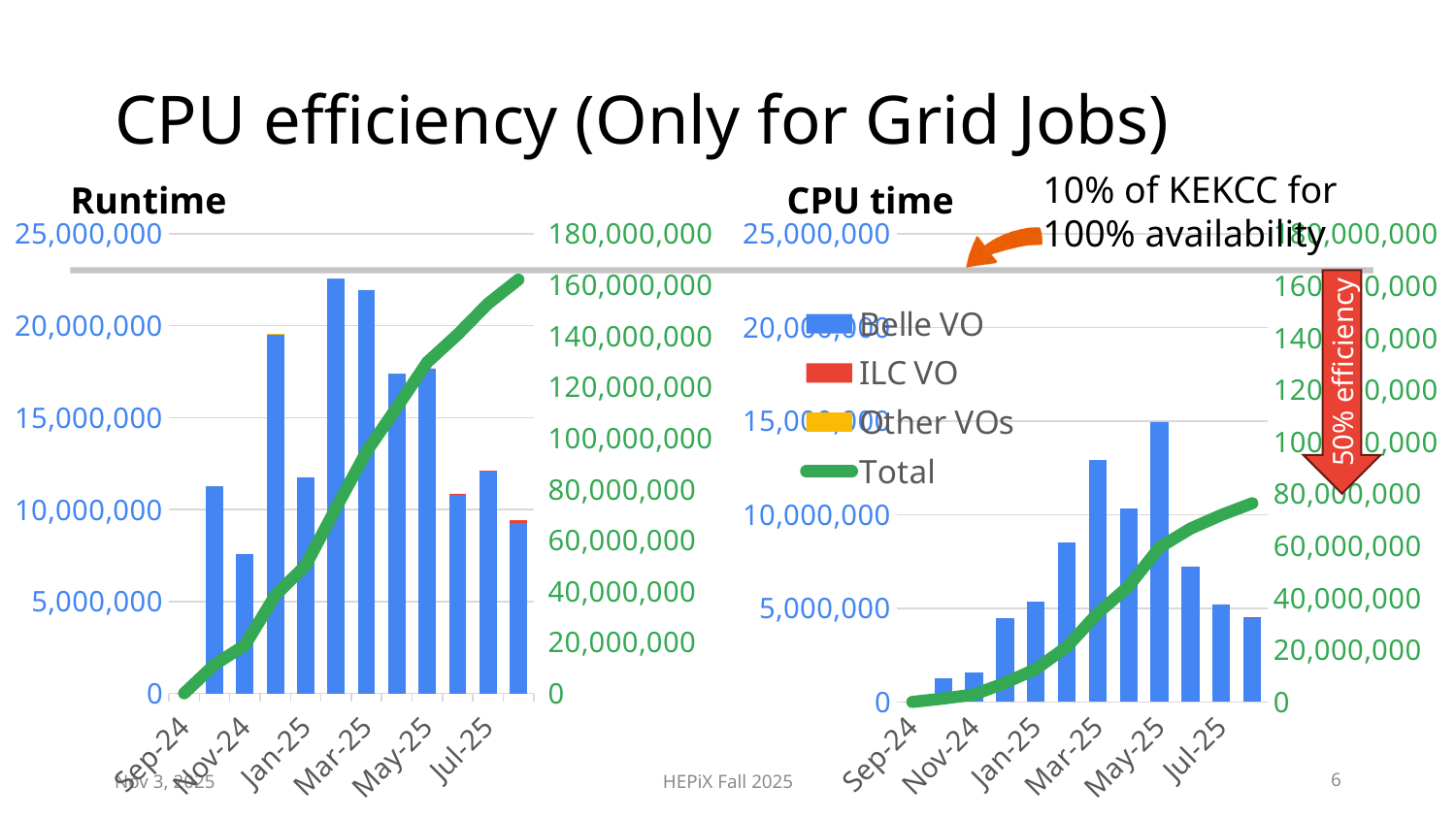
What is the highest tick on the left-hand axis of the Runtime chart? 25,000,000 How many series does the legend list? 4 In the CPU time chart, is the tallest bar greater or less than 20,000,000? less In the Runtime chart, is the tallest bar greater or less than 20,000,000? greater Which series is drawn as a green line in the legend? Total In the CPU time chart, does the Total line rise or fall along the x axis? Rise In the Runtime chart, does the Total line rise or fall from Sep-24 to the right end of the x axis? Rise How many bars are plotted in the CPU time chart? 11 In the CPU time chart, is the final value of the Total line greater or less than 100,000,000? less What kind of chart is the Runtime chart on the left? Bar chart with a line Which chart has the taller tallest bar, Runtime or CPU time? Runtime